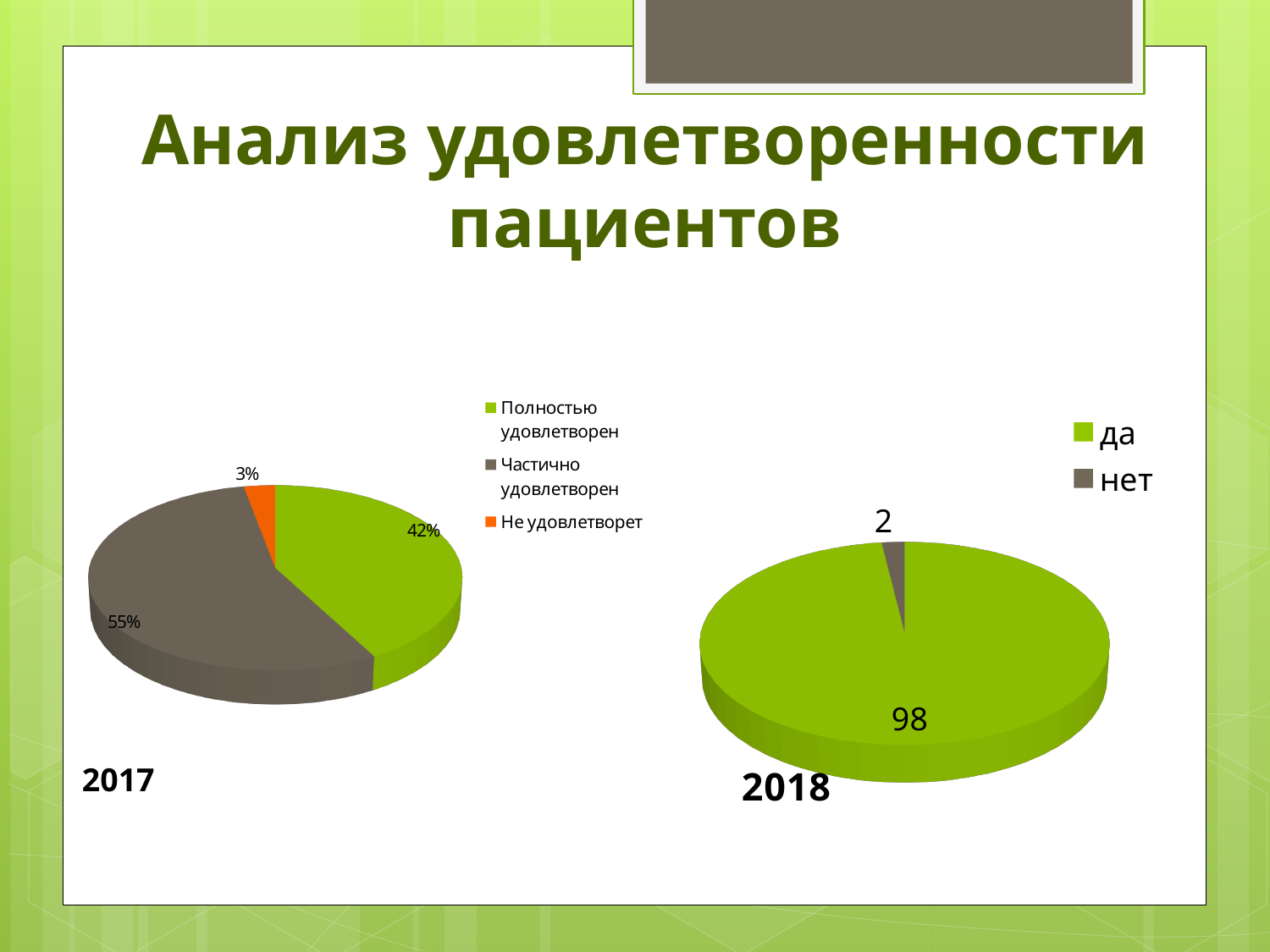
In the 2018 pie chart, what is the value for "да"? 98 In the 2017 pie chart, what is the value for "Полностью удовлетворен"? 42% In the 2017 pie chart, which category has the smallest slice? Не удовлетворет In the 2017 pie chart, which category has the largest slice? Частично удовлетворен In the 2017 pie chart, what is the value for "Не удовлетворет"? 3% In the 2018 pie chart, what is the value for "нет"? 2 How many entries does the legend of the 2018 chart list? 2 In the 2017 pie chart, what is the difference between the values for "Частично удовлетворен" and "Полностью удовлетворен"? 13% In the 2017 pie chart, what is the value for "Частично удовлетворен"? 55% In the 2017 pie chart, how many slices are there? 3 In the 2018 pie chart, which is larger, "да" or "нет"? да What type of chart is the 2018 chart? Pie chart